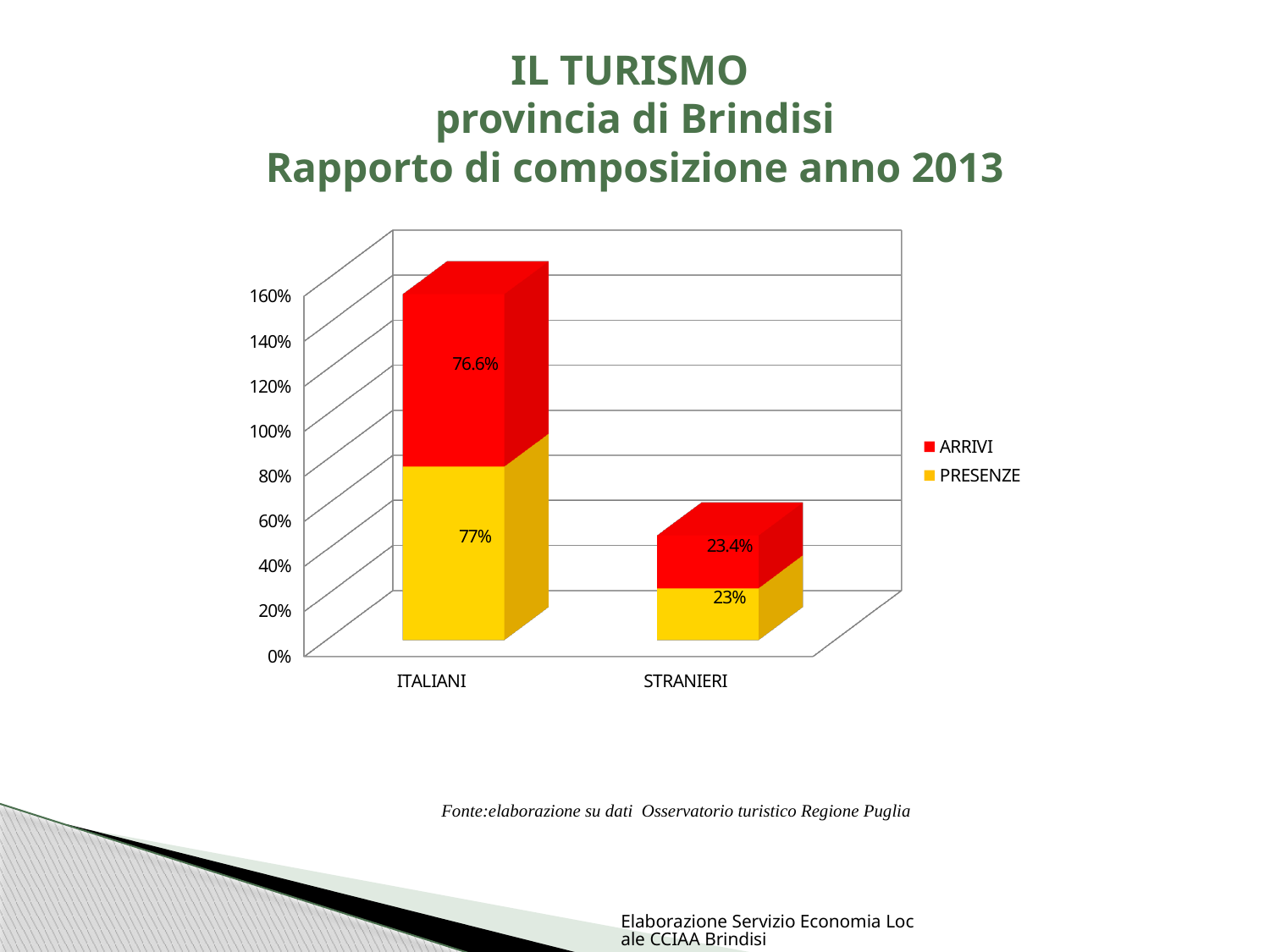
Is the PRESENZE value for ITALIANI larger or smaller than the PRESENZE value for STRANIERI? larger Which category has the lower PRESENZE value? STRANIERI What is the ARRIVI value for STRANIERI? 23.4% What is the PRESENZE value for STRANIERI? 23% What is the difference between the ARRIVI values for ITALIANI and STRANIERI? 53.2% What kind of chart is shown on the slide? Stacked bar chart What is the PRESENZE value for ITALIANI? 77% Which category has the higher ARRIVI value? ITALIANI How many series does the legend list? 2 What is the ARRIVI value for ITALIANI? 76.6% How many categories are shown on the x axis? 2 What is the total height of the stacked bar for STRANIERI? 46.4%